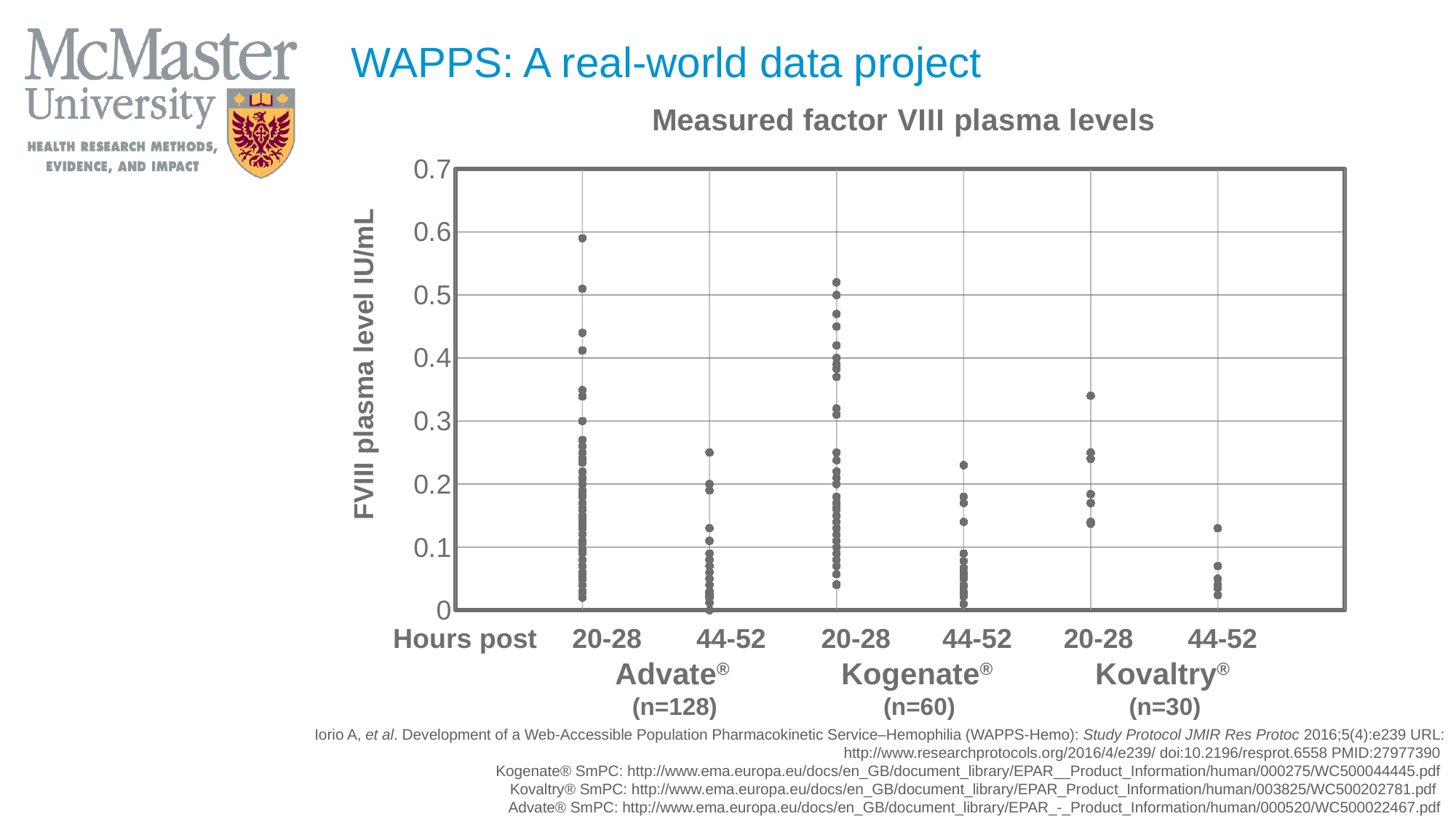
Is the highest measured value for Kogenate at 20-28 hours post greater or less than 0.4? greater For each product, do the measured FVIII plasma levels generally rise or fall from 20-28 hours post to 44-52 hours post? fall Is the highest measured value for Kovaltry at 44-52 hours post greater or less than 0.2? less What is the sample size (n) shown for Kovaltry? n=30 What is the sample size (n) shown for Advate? n=128 Which product has the largest sample size shown under its name? Advate What is the label of the y axis? FVIII plasma level IU/mL How many groups of points (product and time-point combinations) are plotted along the x axis? 6 Is the highest measured value for Advate at 20-28 hours post greater or less than 0.5? greater What is the title of the chart? Measured factor VIII plasma levels How many products are compared on the x axis of the chart? 3 What kind of chart is shown on the slide? Scatter (dot) plot